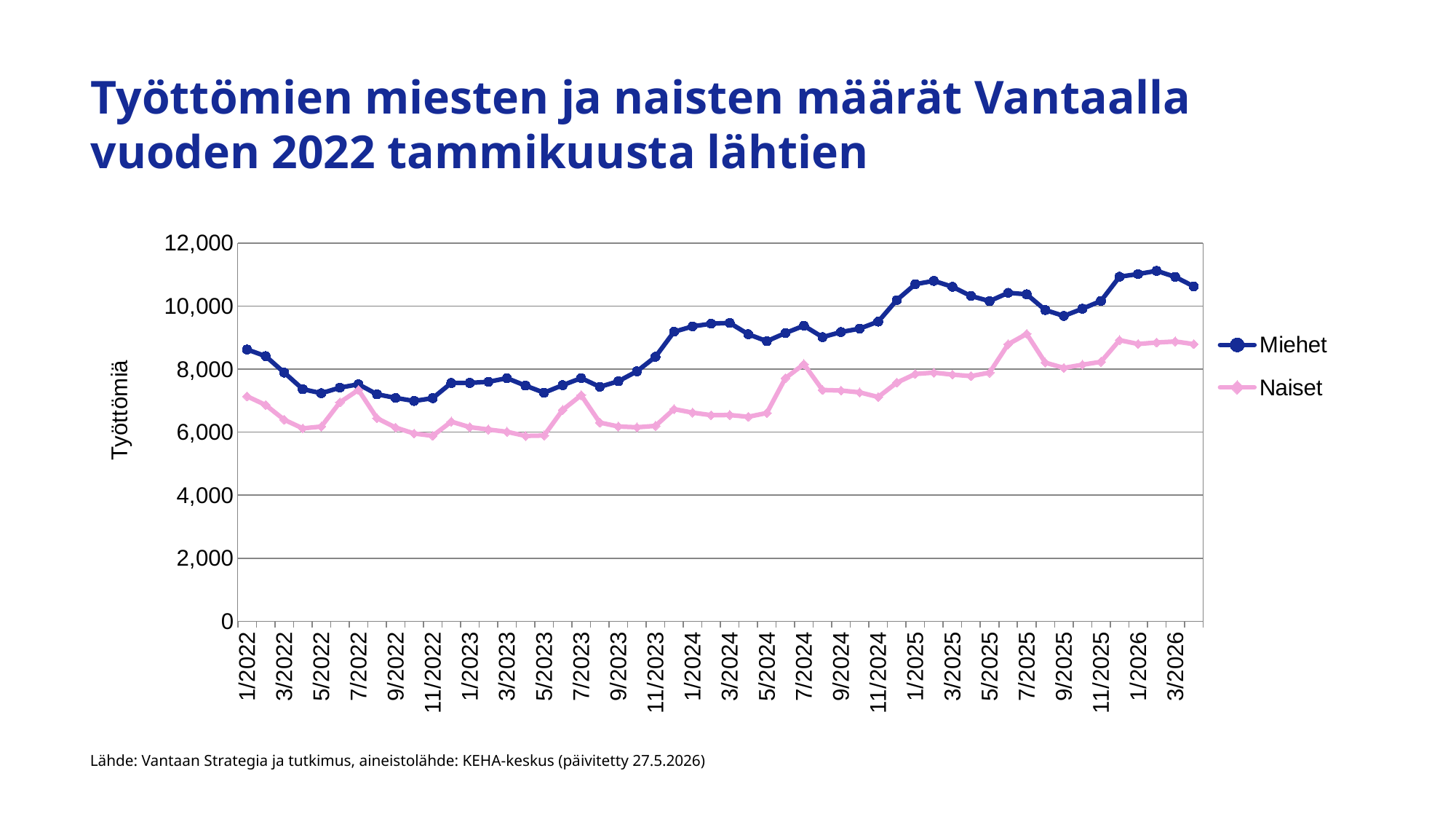
Is the value for Naiset in 7/2025 greater or less than 8,000? greater What are the two series named in the legend? Miehet and Naiset Overall, do the values for Miehet rise or fall from 1/2022 to 3/2026? rise What kind of chart is shown on the slide? line chart Is the value for Naiset in 1/2022 greater or less than 8,000? less What is the label on the vertical axis? Työttömiä Is the value for Miehet in 1/2026 greater or less than 10,000? greater How many series does the legend list? 2 Which series has the higher value in 1/2024, Miehet or Naiset? Miehet